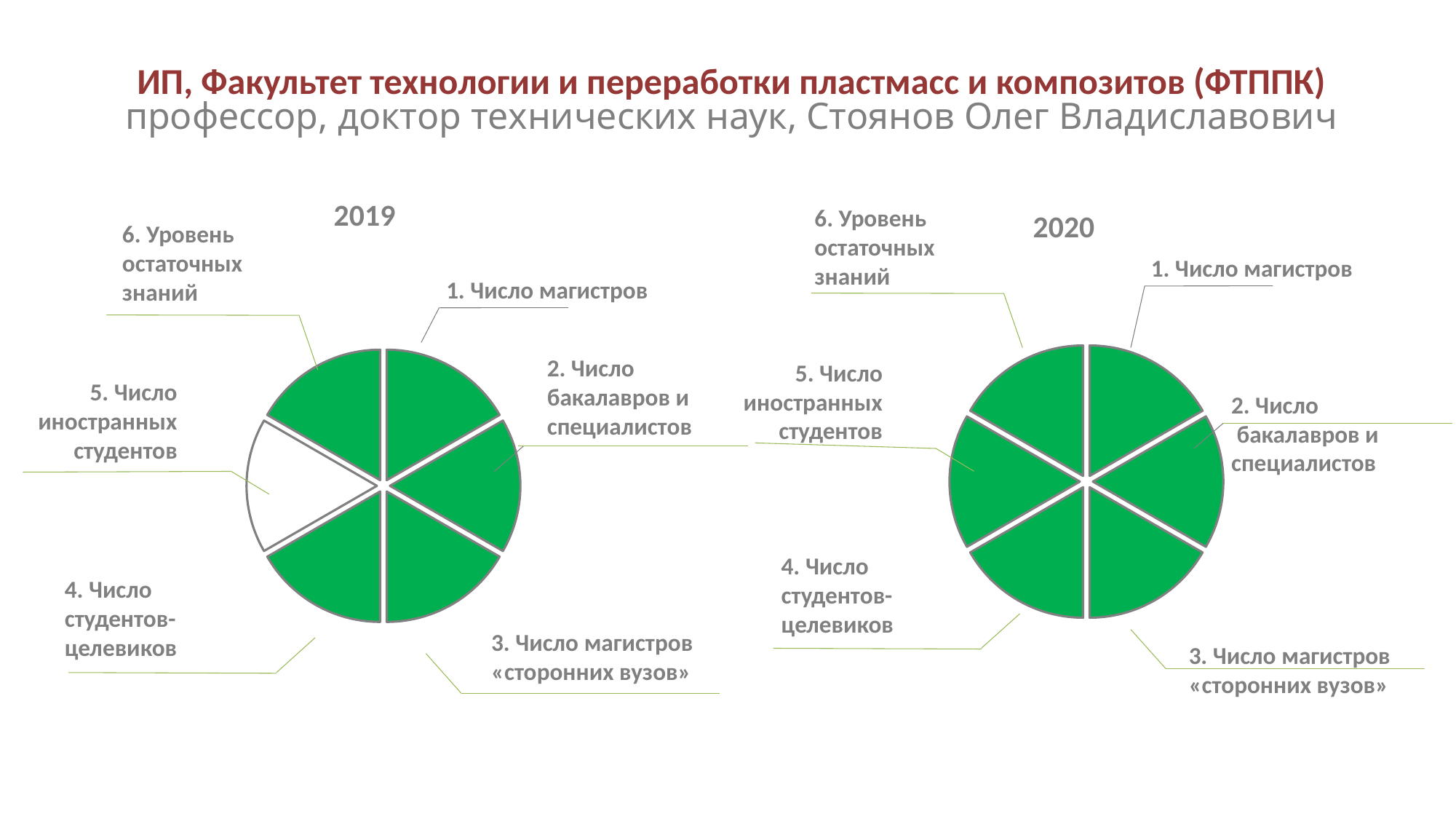
In the 2019 pie chart, which slice is white rather than green? 5. Число иностранных студентов How many slices does the 2019 pie chart have? 6 What kind of chart is the 2019 chart? pie chart What is the title of the left pie chart? 2019 In the 2019 pie chart, which label is numbered 6? Уровень остаточных знаний How many slices does the 2020 pie chart have? 6 What kind of chart is the 2020 chart? pie chart In the 2020 pie chart, which label is numbered 3? Число магистров «сторонних вузов» How many pie charts are shown on the slide? 2